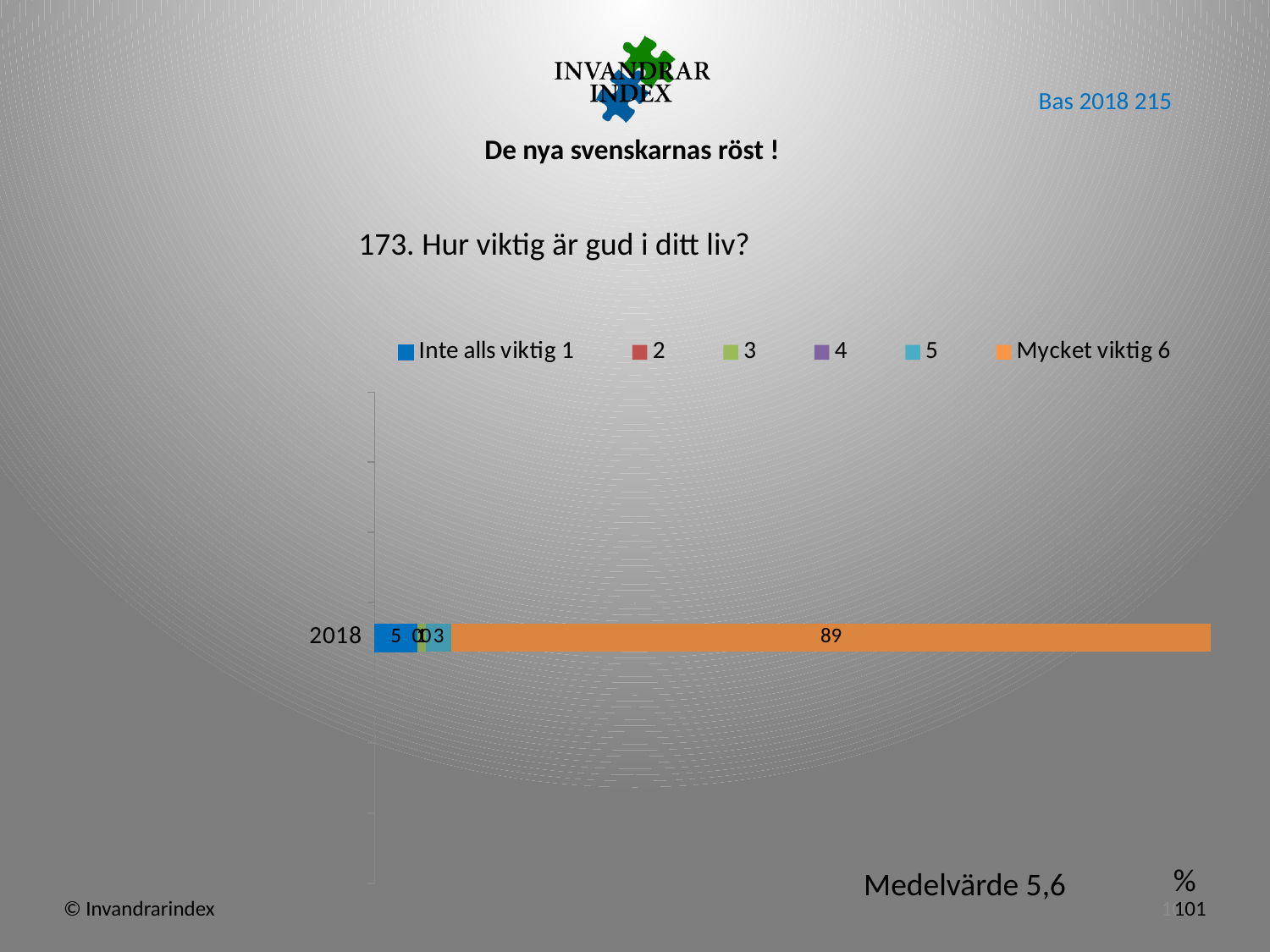
What colour is the 'Mycket viktig 6' series in the chart? orange What kind of chart is shown on the slide? bar chart What is the difference between the 'Mycket viktig 6' value and the 'Inte alls viktig 1' value in 2018? 84 Which is larger in 2018, 'Mycket viktig 6' or 'Inte alls viktig 1'? Mycket viktig 6 Which series has the highest value in 2018? Mycket viktig 6 How many categories (years) are plotted on the y axis? 1 How many series does the legend list? 6 What is the value for 'Mycket viktig 6' in 2018? 89 What is the title of the chart? 173. Hur viktig är gud i ditt liv? What is the value for 'Inte alls viktig 1' in 2018? 5